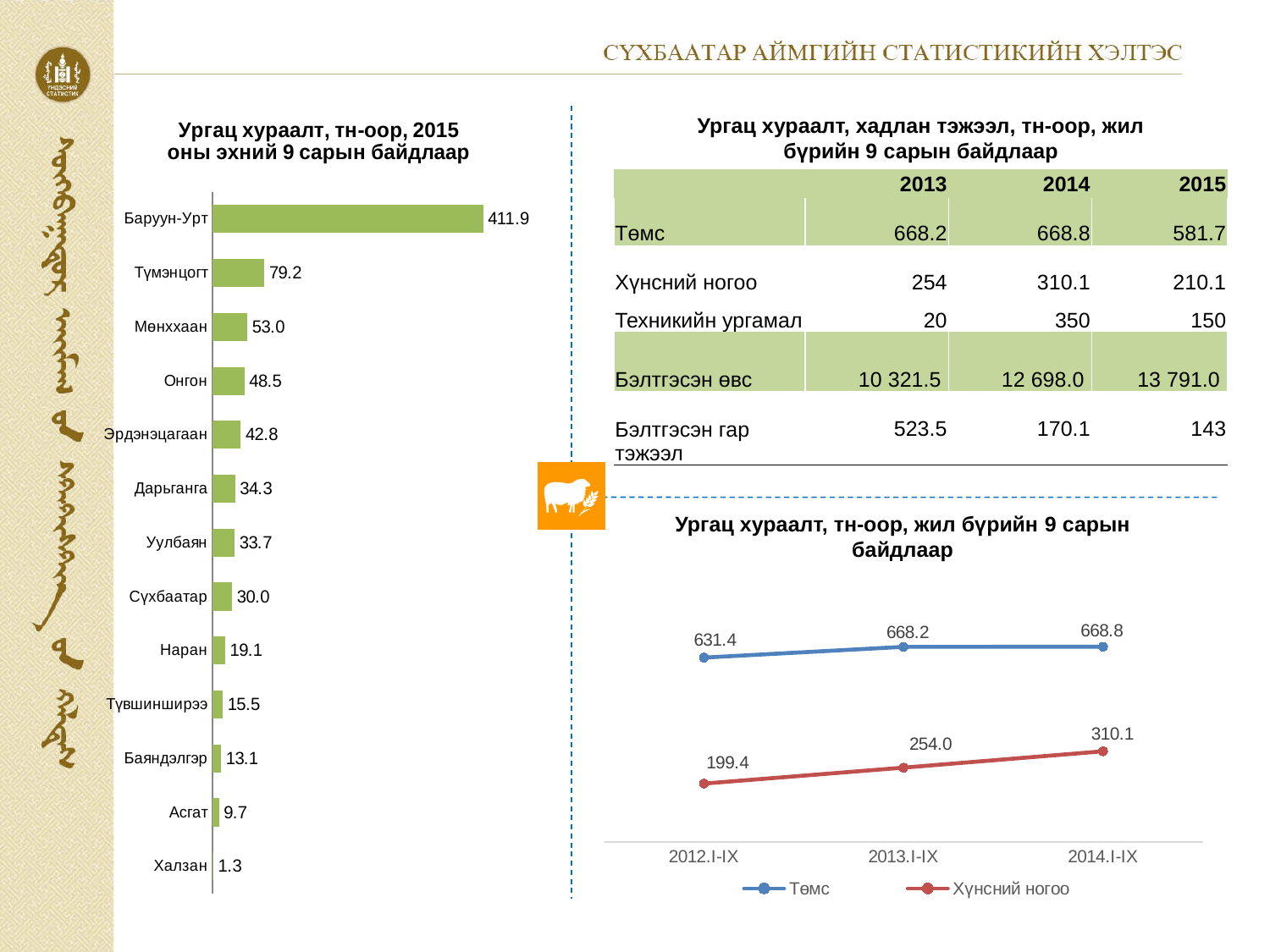
In the line chart 'Ургац хураалт, тн-оор, жил бүрийн 9 сарын байдлаар', what is the value for Төмс in 2013.I-IX? 668.2 In the bar chart 'Ургац хураалт, тн-оор, 2015 оны эхний 9 сарын байдлаар', what is the value for Баруун-Урт? 411.9 What kind of chart is the chart on the left of the slide? Bar chart In the bar chart 'Ургац хураалт, тн-оор, 2015 оны эхний 9 сарын байдлаар', which is larger, Онгон or Эрдэнэцагаан? Онгон In the bar chart 'Ургац хураалт, тн-оор, 2015 оны эхний 9 сарын байдлаар', what is the value for Дарьганга? 34.3 In the line chart 'Ургац хураалт, тн-оор, жил бүрийн 9 сарын байдлаар', does the value for Хүнсний ногоо rise or fall from 2012.I-IX to 2014.I-IX? Rise In the bar chart 'Ургац хураалт, тн-оор, 2015 оны эхний 9 сарын байдлаар', which category has the highest value? Баруун-Урт In the bar chart 'Ургац хураалт, тн-оор, 2015 оны эхний 9 сарын байдлаар', how many categories are shown? 13 In the line chart 'Ургац хураалт, тн-оор, жил бүрийн 9 сарын байдлаар', what is the value for Хүнсний ногоо in 2014.I-IX? 310.1 In the line chart 'Ургац хураалт, тн-оор, жил бүрийн 9 сарын байдлаар', how many series does the legend list? 2 In the bar chart 'Ургац хураалт, тн-оор, 2015 оны эхний 9 сарын байдлаар', what is the difference between Түмэнцогт and Мөнххаан? 26.2 In the bar chart 'Ургац хураалт, тн-оор, 2015 оны эхний 9 сарын байдлаар', which category has the lowest value? Халзан